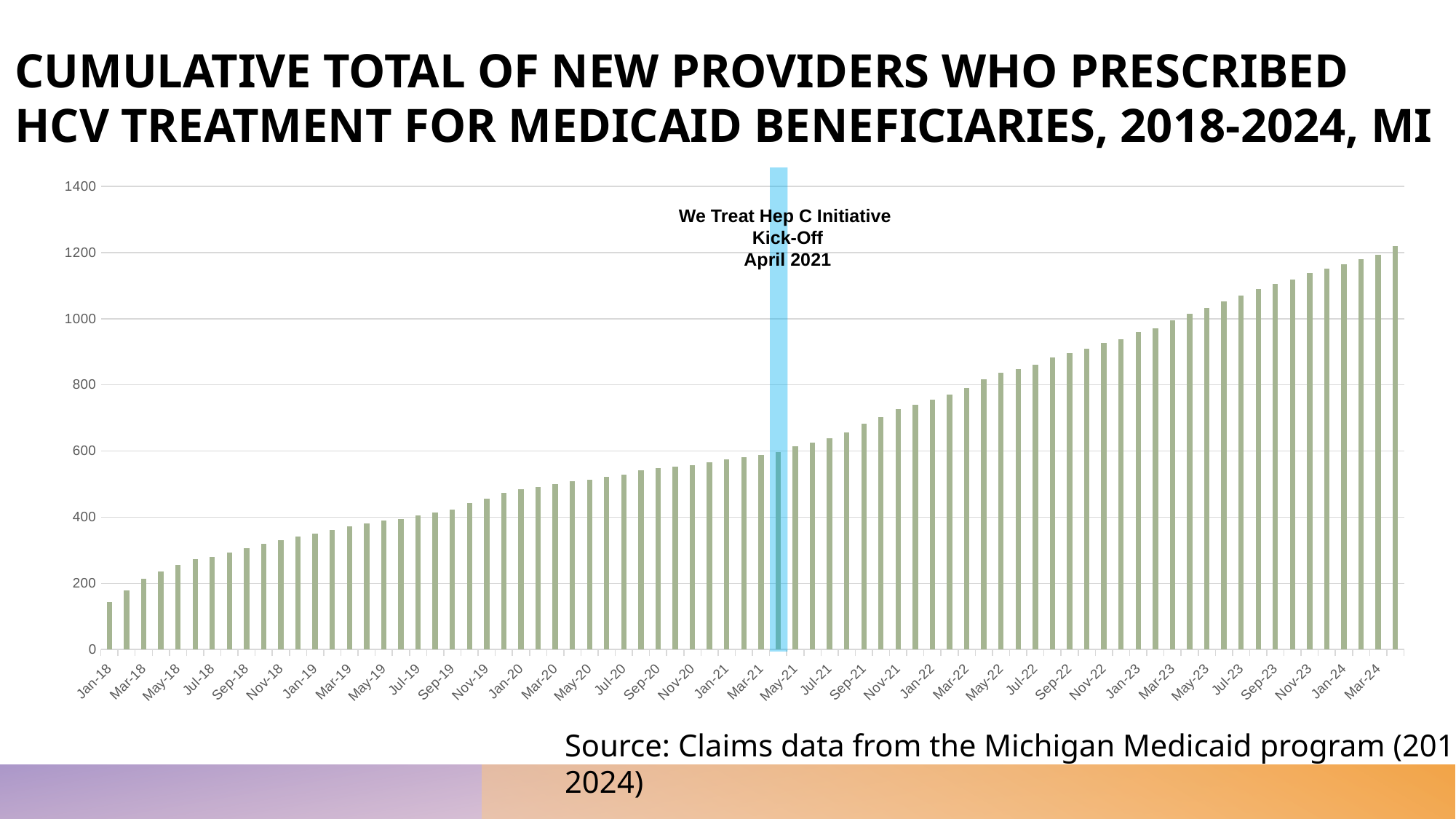
Which is larger, the value for Jan-19 or the value for Jan-20? Jan-20 Is the value for Mar-24 greater or less than 1000? greater Do the values rise or fall from Jan-18 to Mar-24? rise Is the value for Jan-23 greater or less than 1000? less What event does the annotation on the chart mark, and in which month? We Treat Hep C Initiative Kick-Off, April 2021 Is the value for Jan-18 greater or less than 200? less What kind of chart is shown on the slide? bar chart Which month has the highest cumulative total of new providers? Apr-24 Which month has the lowest cumulative total of new providers? Jan-18